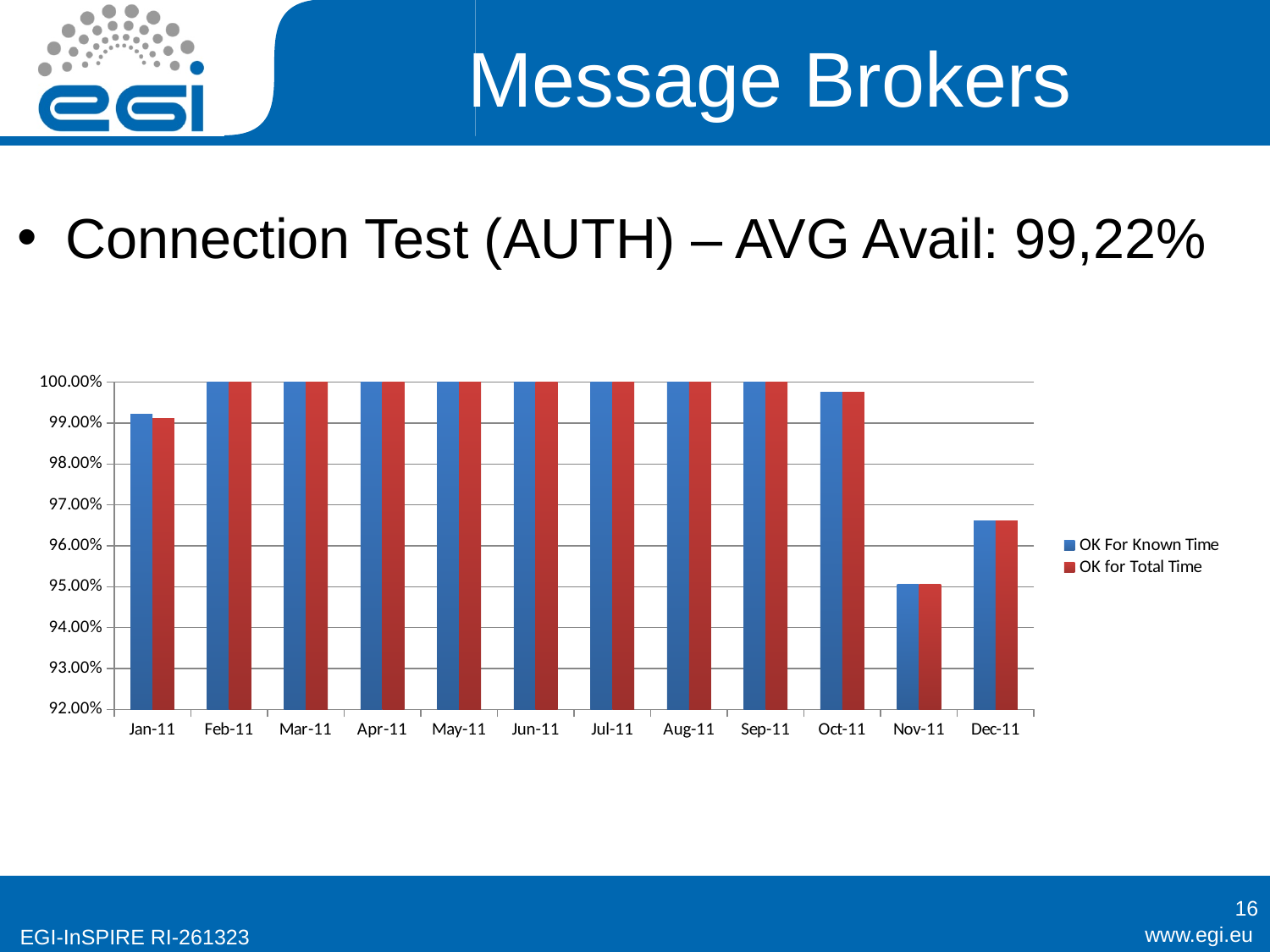
What is the value for OK For Known Time in Feb-11? 100.00% What kind of chart is shown on the slide? bar chart Which is larger, the OK For Known Time value for Oct-11 or for Nov-11? Oct-11 What is the value for OK for Total Time in Sep-11? 100.00% How many months are shown on the x axis? 12 Is the value for OK for Total Time in Dec-11 greater or less than 96.00%? greater Which is larger, the OK for Total Time value for Dec-11 or for Nov-11? Dec-11 What colour are the bars for the OK for Total Time series? red Is the value for OK For Known Time in Nov-11 greater or less than 96.00%? less Which month has the lowest value for OK For Known Time? Nov-11 How many series does the legend list? 2 Is the value for OK For Known Time in Jan-11 greater or less than 99.00%? greater